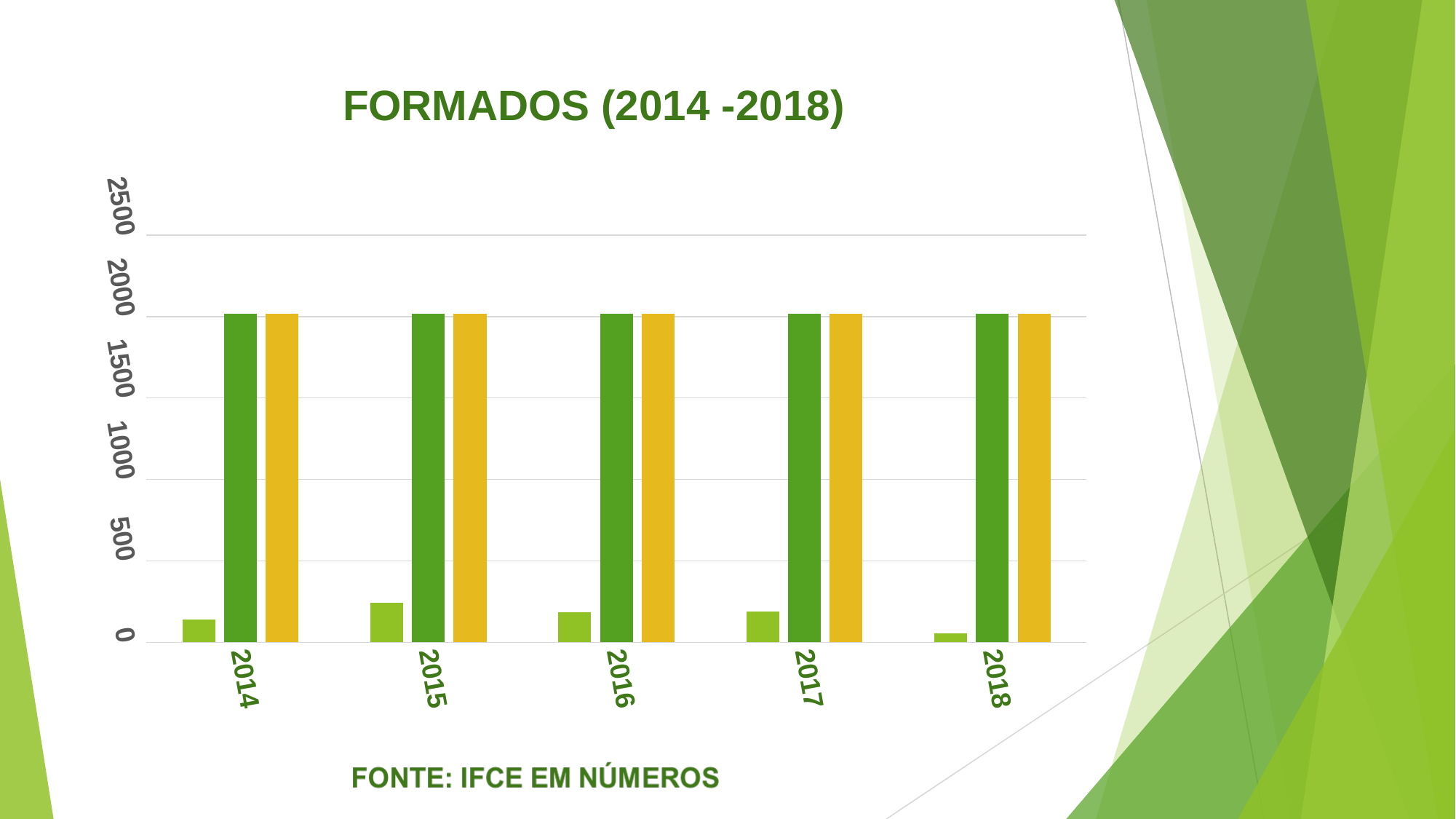
Which is larger, the light green bar for 2015 or the light green bar for 2018? 2015 How many bars are plotted for each year in the chart? 3 Which is larger in 2014, the light green bar or the dark green bar? the dark green bar Is the dark green bar for 2016 greater or less than 1500? greater What kind of chart is shown on the slide? bar chart Is the light green bar for 2018 greater or less than 500? less What is the title of the chart? FORMADOS (2014 -2018) Which year has the lowest light green bar? 2018 Is the yellow bar for 2018 greater or less than 2500? less How many years are shown on the x axis of the chart? 5 Which year has the highest light green bar? 2015